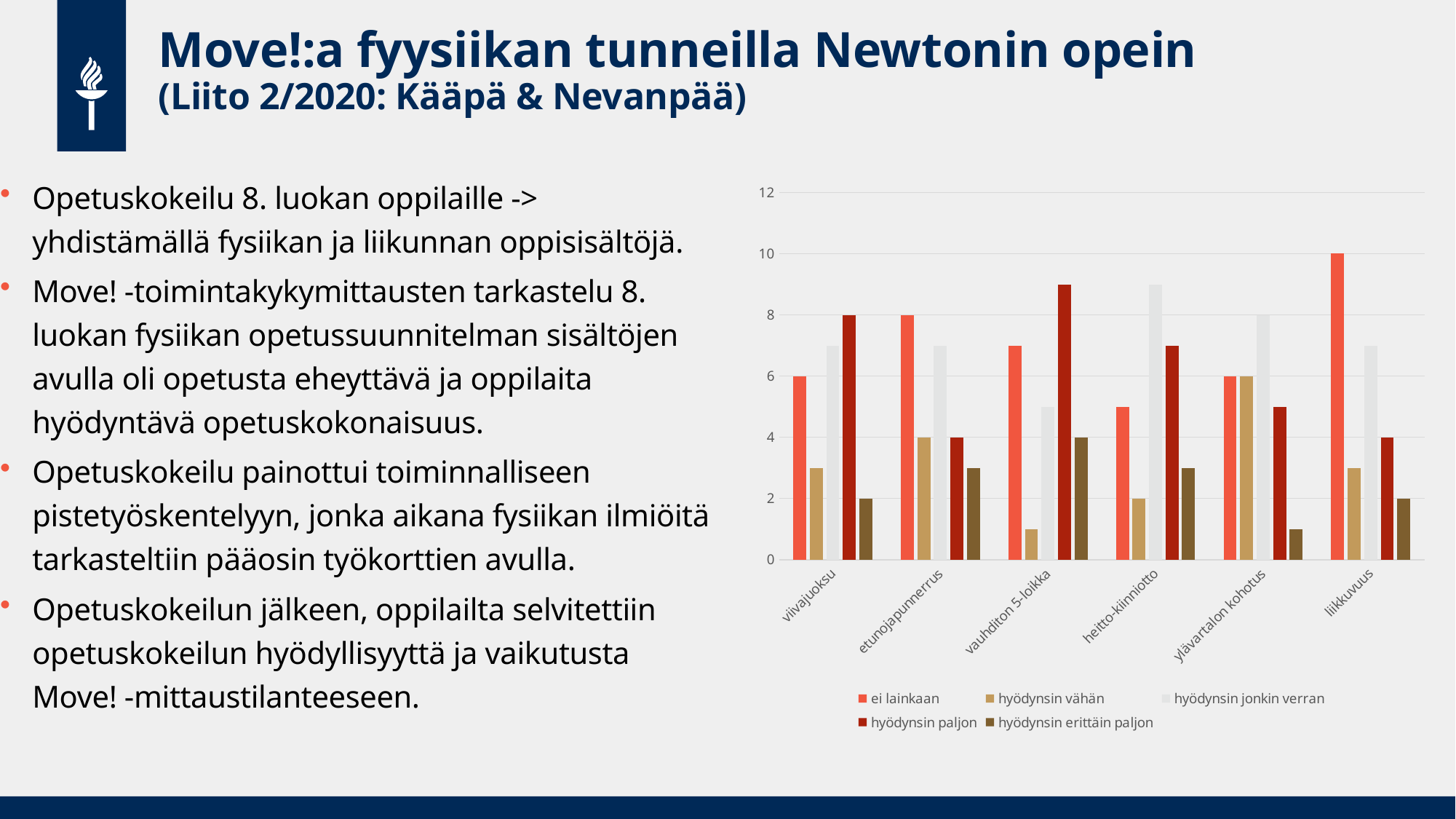
What is the value of 'hyödynsin jonkin verran' for ylävartalon kohotus? 8 What is the difference between the 'ei lainkaan' values for liikkuvuus and viivajuoksu? 4 What is the value of 'hyödynsin paljon' for viivajuoksu? 8 What is the value of 'hyödynsin vähän' for heitto-kiinniotto? 2 How many categories are shown on the x axis of the chart? 6 For which category is the 'hyödynsin erittäin paljon' value lowest? ylävartalon kohotus Is the 'hyödynsin paljon' value for vauhditon 5-loikka greater or less than 8? greater What is the value of 'ei lainkaan' for liikkuvuus? 10 For which category is the 'ei lainkaan' value highest? liikkuvuus How many series does the chart legend list? 5 Which is larger: the 'ei lainkaan' value for etunojapunnerrus or for heitto-kiinniotto? etunojapunnerrus What type of chart is shown on the slide? bar chart